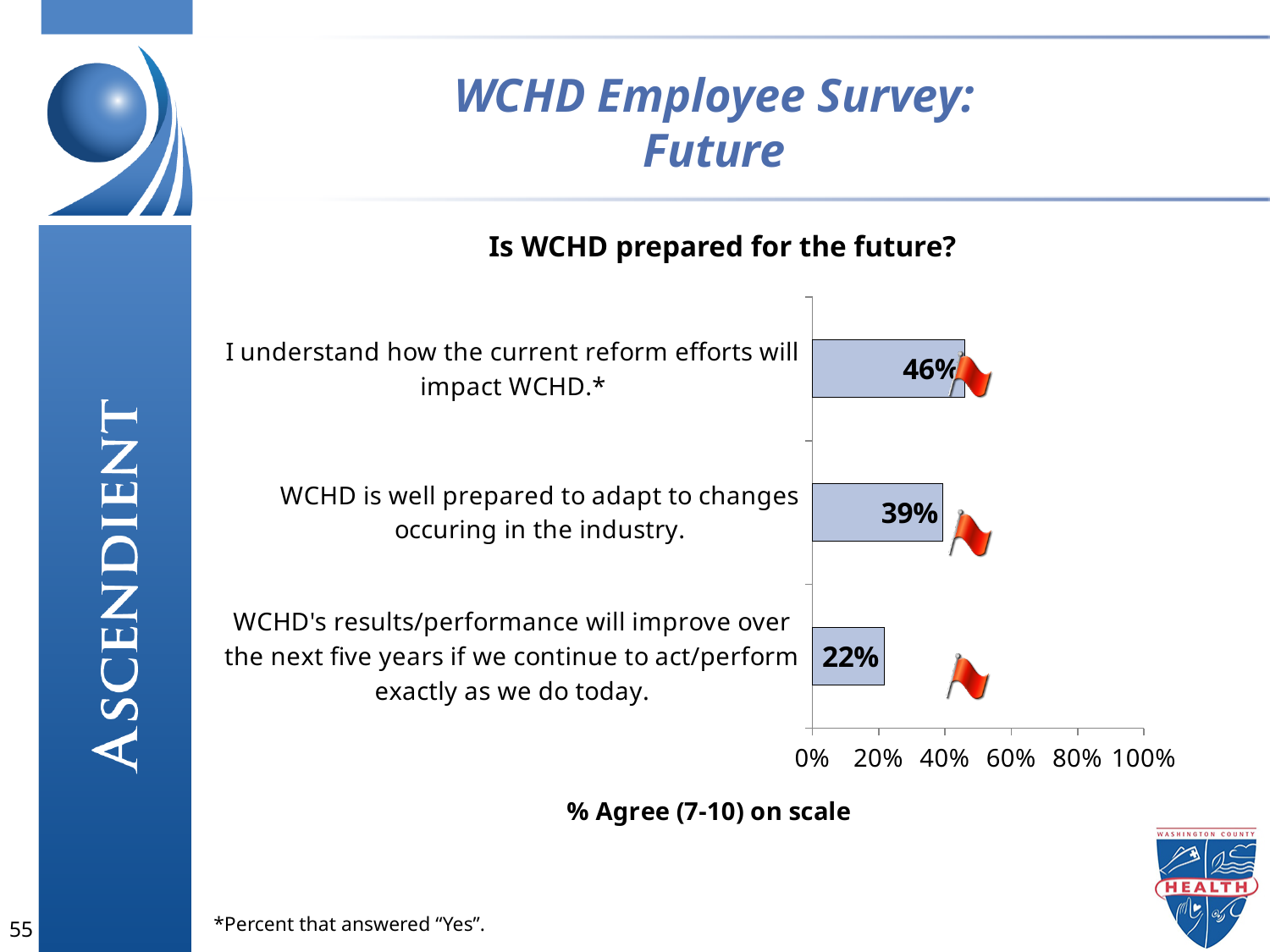
Which is larger: the value for "WCHD is well prepared to adapt to changes occuring in the industry" or the value for "WCHD's results/performance will improve over the next five years"? WCHD is well prepared to adapt to changes occuring in the industry Which statement has the lowest percentage of agreement? WCHD's results/performance will improve over the next five years if we continue to act/perform exactly as we do today. Which statement has the highest percentage of agreement? I understand how the current reform efforts will impact WCHD. What type of chart is shown on the slide? Bar chart What is the title of the chart? Is WCHD prepared for the future? Is the value for "I understand how the current reform efforts will impact WCHD" greater or less than 50%? less What percentage agreed that WCHD is well prepared to adapt to changes occurring in the industry? 39% What percentage agreed with "I understand how the current reform efforts will impact WCHD."? 46% What is the difference between the value for "I understand how the current reform efforts will impact WCHD" and the value for "WCHD is well prepared to adapt to changes occuring in the industry"? 7 percentage points How many statements are plotted on the chart? 3 What is the difference in percentage points between the highest and lowest values on the chart? 24 What percentage agreed that WCHD's results/performance will improve over the next five years if it continues to act/perform exactly as it does today? 22%